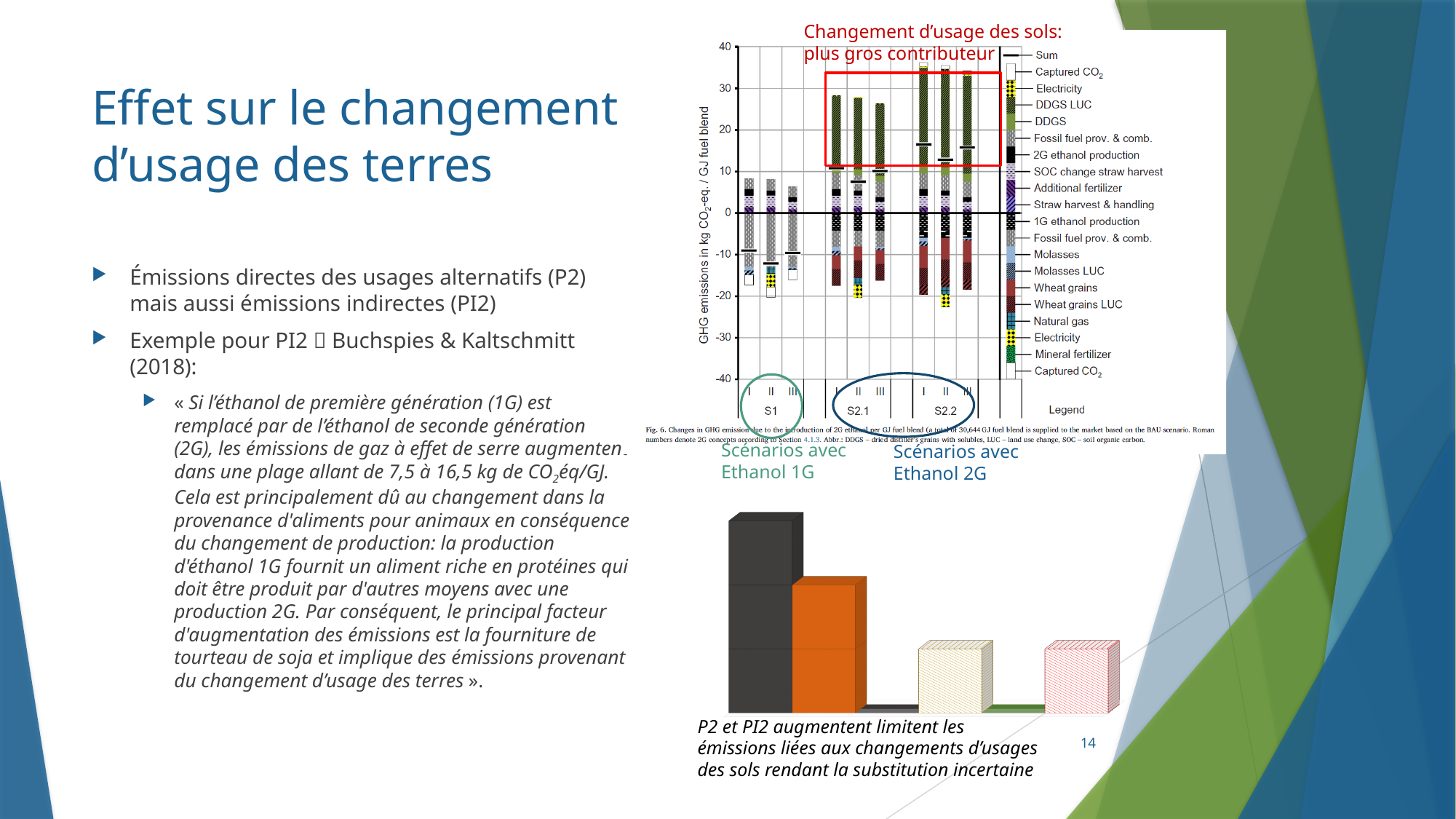
In the GHG emissions chart, how many scenario groups are shown on the x axis? 3 In the GHG emissions chart, what is the y-axis label? GHG emissions in kg CO2-eq. / GJ fuel blend In the GHG emissions chart, which scenario group has the highest Sum values: S1, S2.1 or S2.2? S2.2 In the GHG emissions chart, how many bars (scenario variants) are plotted in total? 9 In the GHG emissions chart, is the Sum value for scenario S1 I greater or less than 0? less In the GHG emissions chart, is the Sum value for scenario S2.1 I greater or less than 20? less In the GHG emissions chart, what are the labels of the three scenario groups on the x axis? S1, S2.1, S2.2 What kind of chart is the GHG emissions chart at the top right of the slide? Stacked bar chart In the GHG emissions chart, is the Sum value for scenario S2.2 I greater or less than 10? greater In the GHG emissions chart, which has the larger Sum value: scenario S1 I or scenario S2.2 I? S2.2 I In the GHG emissions chart, how many entries does the legend list? 20